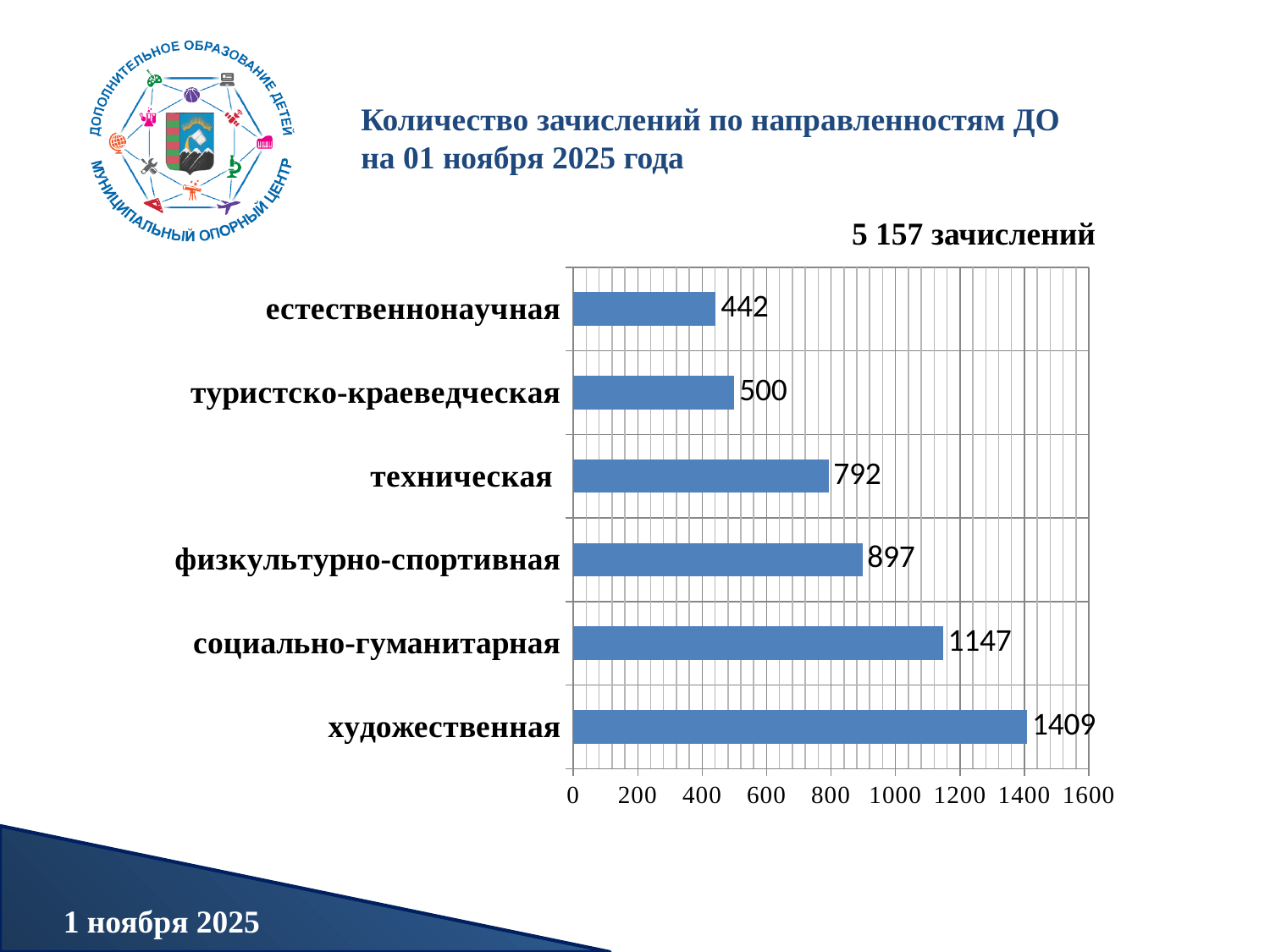
How many categories are shown in the chart? 6 What is the value for художественная? 1409 What total number of enrollments is stated above the chart? 5 157 зачислений Which is larger, техническая or физкультурно-спортивная? физкультурно-спортивная What is the difference between художественная and социально-гуманитарная? 262 Which category has the highest value? художественная What kind of chart is shown on the slide? bar chart Is the value for социально-гуманитарная greater or less than 1000? greater What is the value for социально-гуманитарная? 1147 What is the difference between физкультурно-спортивная and техническая? 105 Which category has the lowest value? естественнонаучная What is the value for туристско-краеведческая? 500